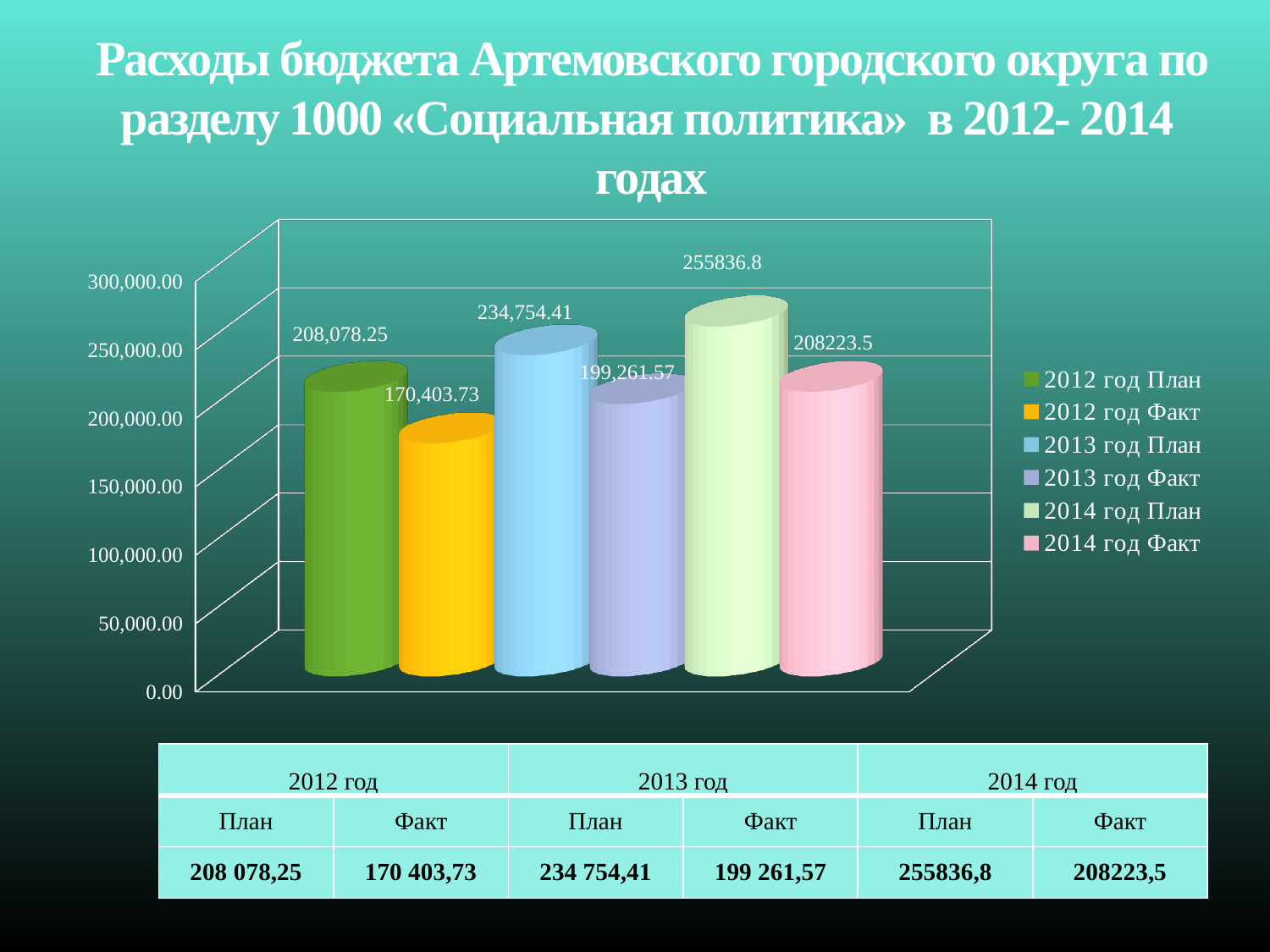
Is the value for 2014 год Факт greater or less than 250,000.00? less Which is larger, 2013 год План or 2014 год Факт? 2013 год План How many series does the legend list? 6 What is the value shown for 2013 год Факт? 199,261.57 What is the value shown for 2012 год План? 208,078.25 What is the difference between 2014 год План and 2014 год Факт? 47613.3 What kind of chart is shown on the slide? bar chart Which series has the highest value on the chart? 2014 год План What is the value shown for 2014 год Факт? 208223.5 Which series has the lowest value on the chart? 2012 год Факт What is the value shown for 2014 год План? 255836.8 What is the difference between 2012 год План and 2012 год Факт? 37,674.52